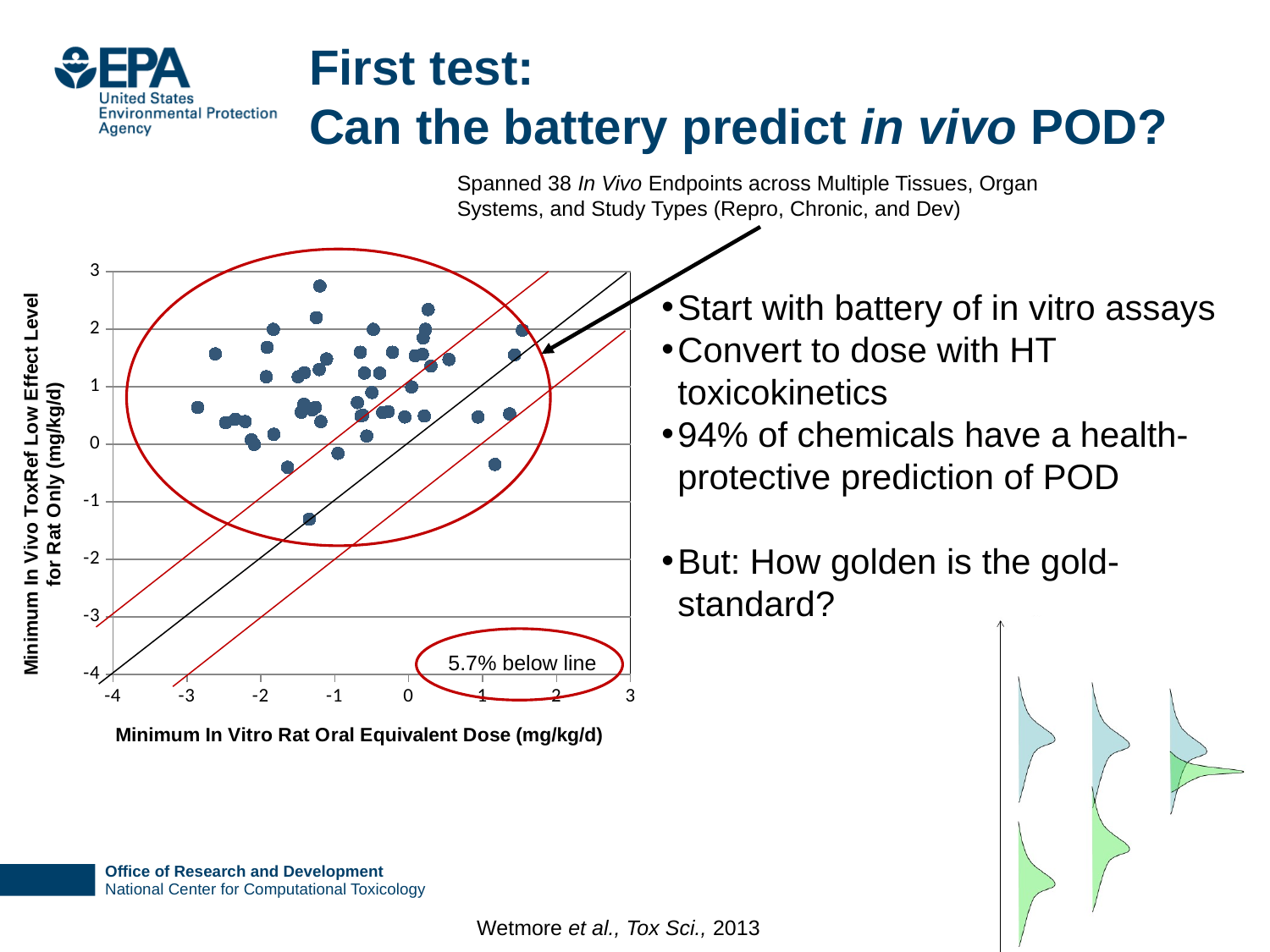
What kind of chart is shown on the slide? scatter chart According to the annotation on the scatter chart, what percentage of points fall below the line? 5.7% What is the title of the x axis of the scatter chart? Minimum In Vitro Rat Oral Equivalent Dose (mg/kg/d) Is the y value of the lowest plotted point on the scatter chart greater or less than -1? less Is the x value of the rightmost plotted point on the scatter chart greater or less than 2? less Is the y value of the highest plotted point on the scatter chart greater or less than 2? greater